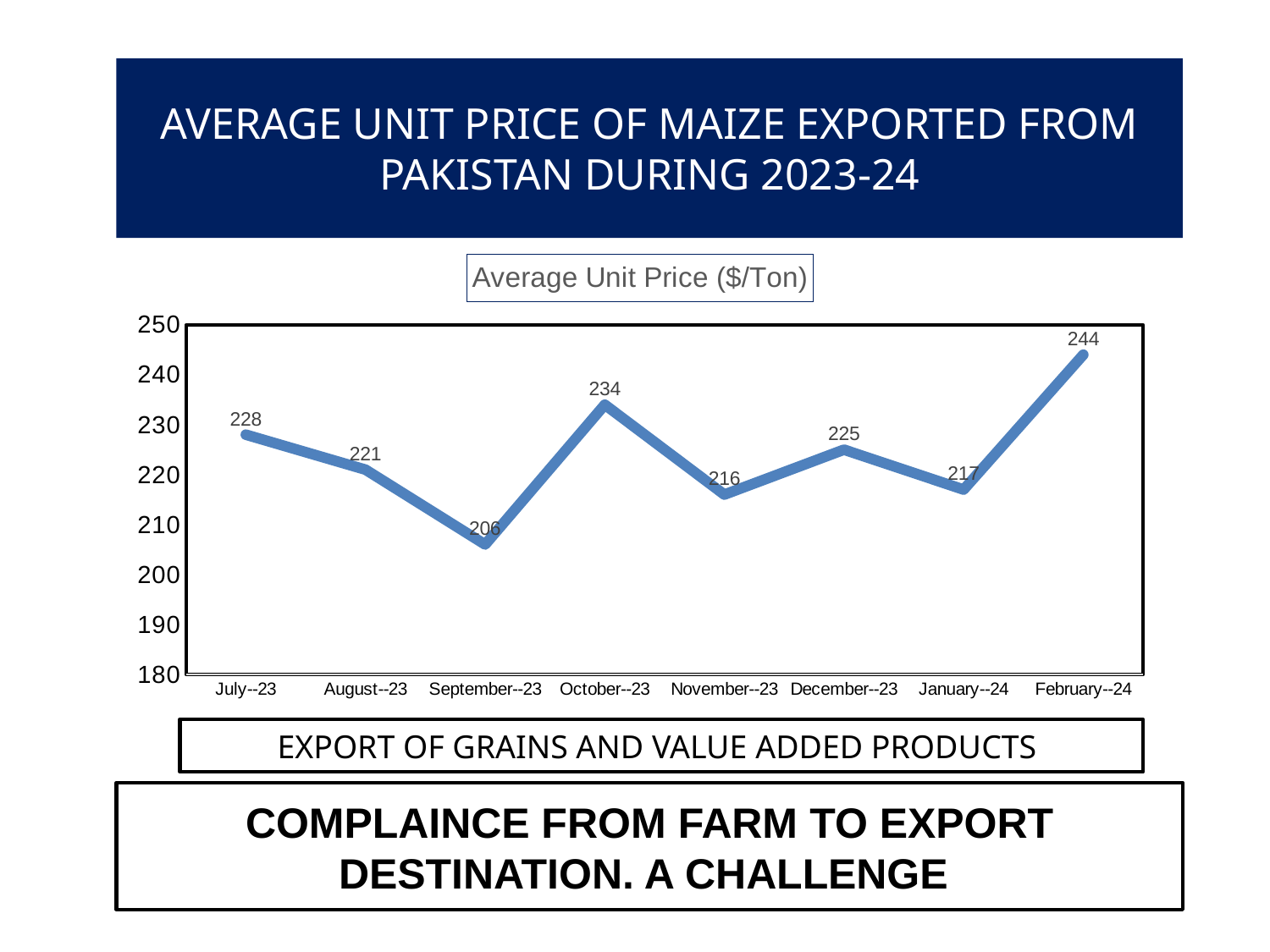
Is the average unit price for October 2023 greater or less than 230? greater What was the average unit price of maize exported in September 2023? 206 What was the average unit price of maize exported in October 2023? 234 How many months are plotted on the chart? 8 Which month had the highest average unit price of maize? February--24 What was the average unit price of maize exported in December 2023? 225 What is the difference between the average unit price in July 2023 and in August 2023? 7 Which month had the lowest average unit price of maize? September--23 Which month had a higher average unit price, November 2023 or January 2024? January--24 What is the difference between the average unit price in February 2024 and in September 2023? 38 What type of chart is shown on the slide? Line chart What is the title shown above the chart's plot area? Average Unit Price ($/Ton)